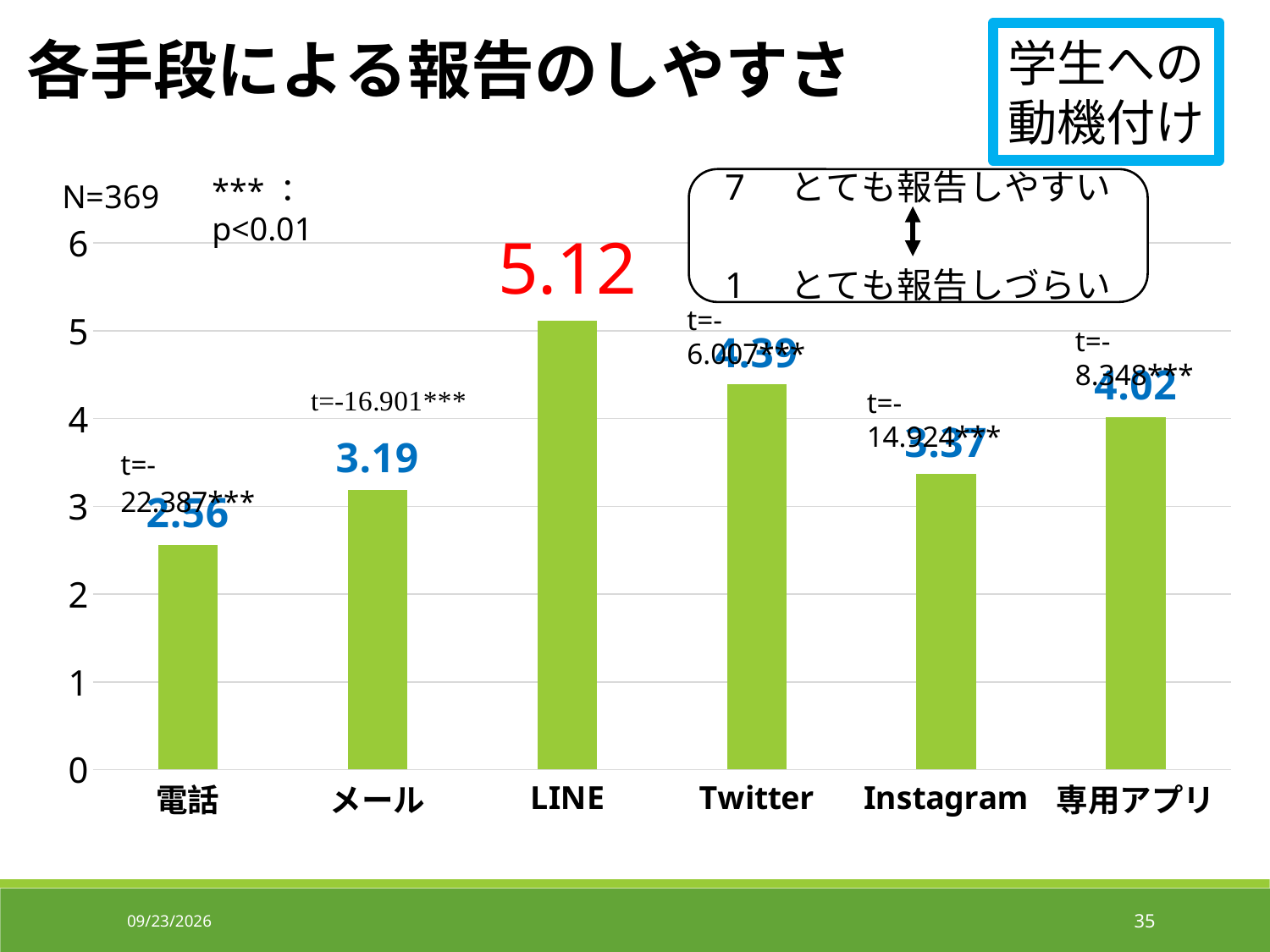
What is the difference between the values for LINE and 電話? 2.56 How many categories are shown on the x axis? 6 What is the value for 電話? 2.56 Is the value for Instagram greater or less than 3? greater Which category has the lowest value? 電話 What is the value for メール? 3.19 What is the difference between the values for Twitter and Instagram? 1.02 Which is larger, the value for Twitter or the value for 専用アプリ? Twitter Which category has the highest value? LINE What kind of chart is shown on the slide? bar chart What is the value for LINE? 5.12 What is the value for 専用アプリ? 4.02